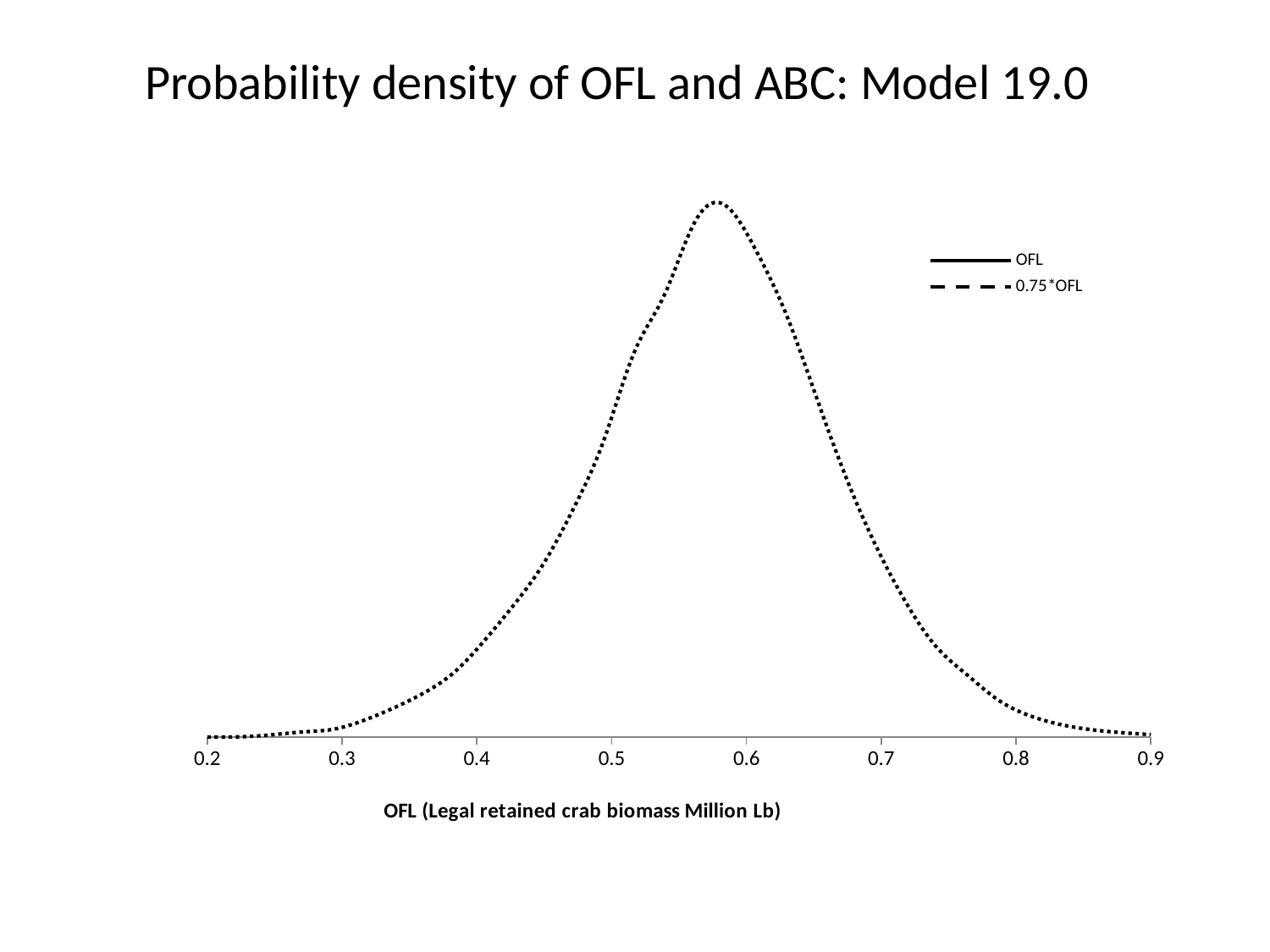
Does the curve rise or fall as the x axis goes from 0.6 to 0.9? fall Is the curve higher at x = 0.4 or at x = 0.6? 0.6 How many tick labels are shown on the x axis? 8 Is the peak of the curve located at an x value greater or less than 0.7? less What is the label of the x axis? OFL (Legal retained crab biomass Million Lb) How many series does the legend list? 2 What is the title of the chart? Probability density of OFL and ABC: Model 19.0 Between which two x-axis tick labels does the curve reach its highest point? 0.5 and 0.6 What kind of chart is shown on the slide? line chart Is the peak of the curve located at an x value greater or less than 0.5? greater Is the curve higher at x = 0.5 or at x = 0.7? 0.5 Does the curve rise or fall as the x axis goes from 0.2 to 0.5? rise